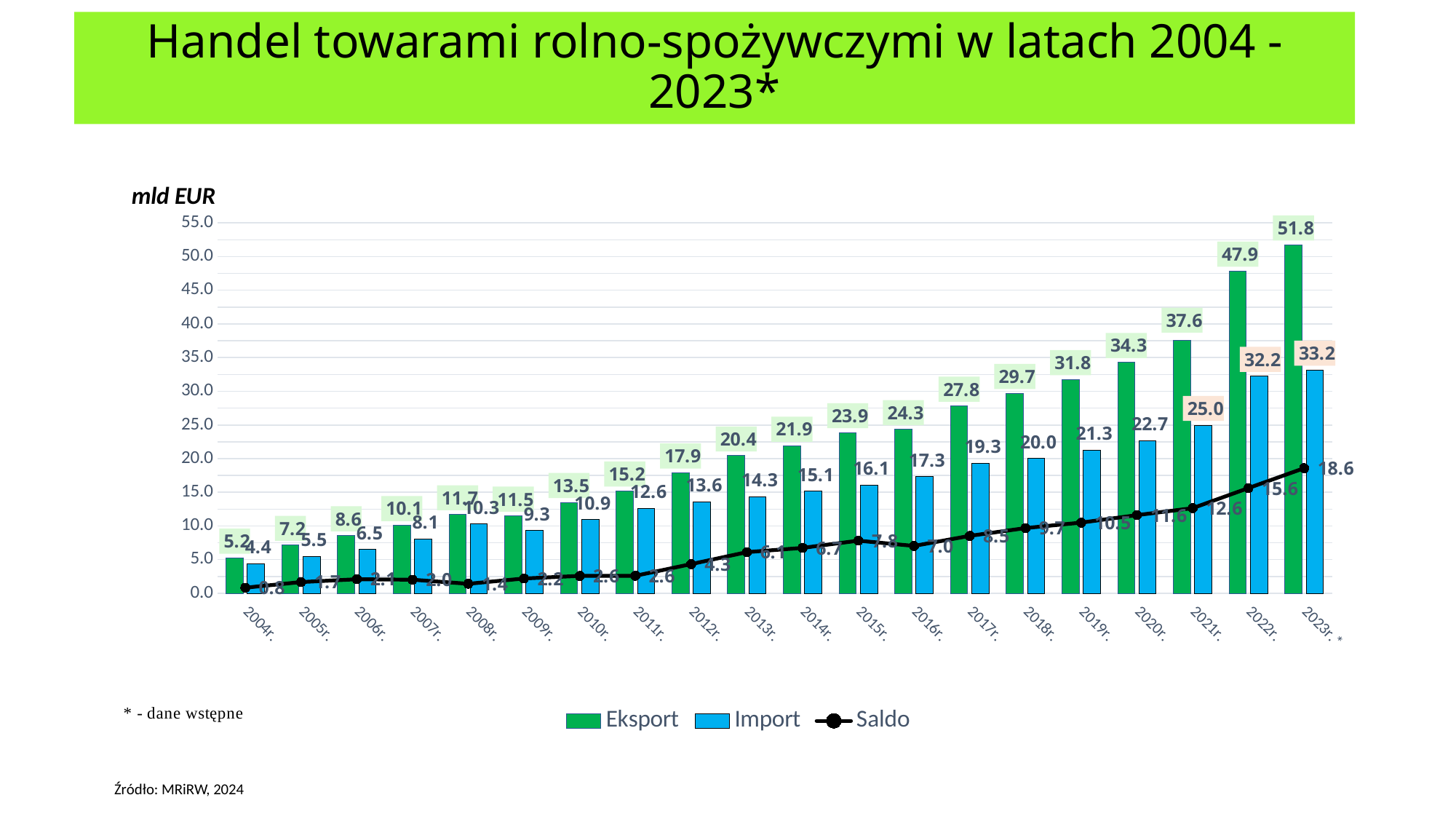
Does the Eksport value rise or fall from 2012r. to 2023r.? Rise How many series does the legend list? 3 By how much did Eksport increase from 2021r. to 2022r.? 10.3 How many years are shown on the x axis? 20 What kind of chart is this? Bar chart with a line series What is the Import value for 2022r.? 32.2 Which is larger, the Eksport value for 2008r. or for 2009r.? 2008r. What is the Saldo value for 2023r.? 18.6 What is the Eksport value for 2023r.? 51.8 Which year has the lowest Import value? 2004r. What is the difference between the Eksport and Import values for 2023r.? 18.6 Which year has the highest Eksport value? 2023r.